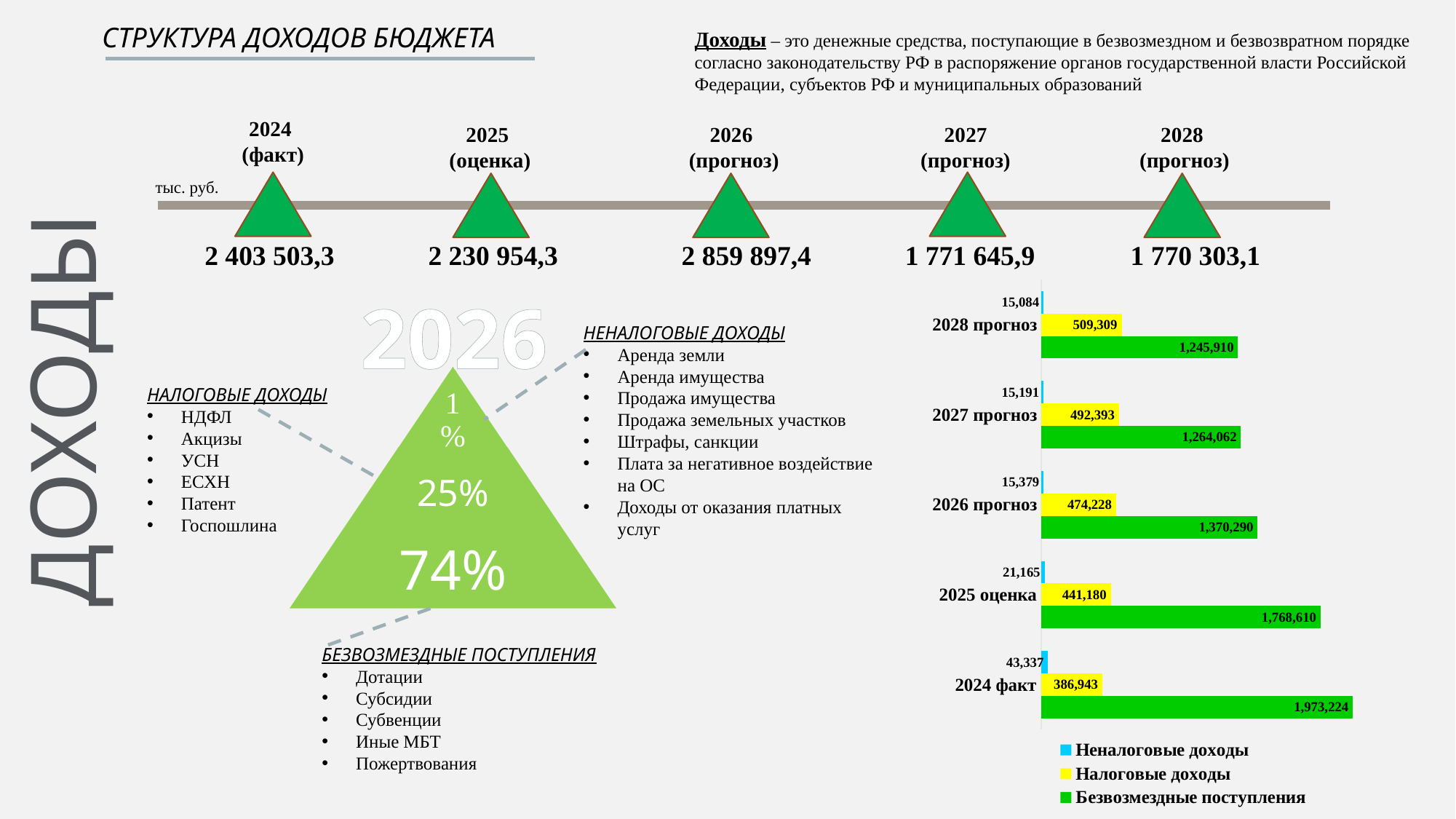
In the bar chart, which category has the highest value for Безвозмездные поступления? 2024 факт In the bar chart, what is the value of Налоговые доходы for 2027 прогноз? 492,393 In the bar chart, which is larger: Налоговые доходы for 2025 оценка or for 2026 прогноз? 2026 прогноз In the bar chart, which category has the highest value for Налоговые доходы? 2028 прогноз In the bar chart, what is the value of Безвозмездные поступления for 2024 факт? 1,973,224 In the bar chart, do the values for Безвозмездные поступления rise or fall from 2024 факт to 2028 прогноз? fall In the bar chart, what is the difference between Безвозмездные поступления for 2024 факт and for 2028 прогноз? 727,314 How many categories (years) are shown in the bar chart? 5 In the bar chart, what is the difference between Налоговые доходы for 2028 прогноз and for 2024 факт? 122,366 How many series does the legend of the bar chart list? 3 In the bar chart, what is the value of Неналоговые доходы for 2025 оценка? 21,165 In the bar chart, which category has the lowest value for Неналоговые доходы? 2028 прогноз